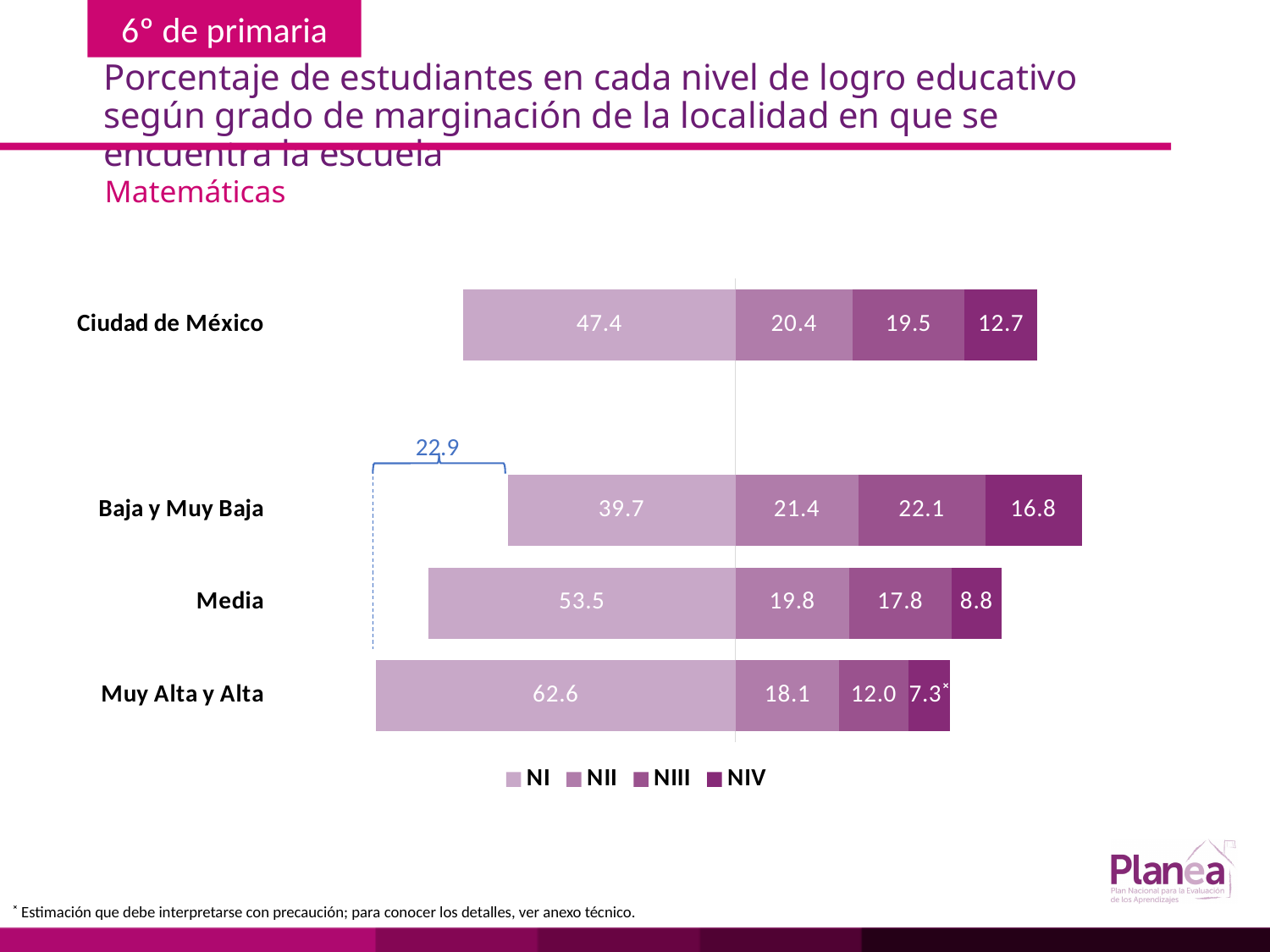
Which category has the lowest NIV value? Muy Alta y Alta What is the NII value for Media? 19.8 What is the NIII value for Muy Alta y Alta? 12.0 Which is larger: the NIII value for Baja y Muy Baja or the NIII value for Ciudad de México? Baja y Muy Baja What is the NIV value for Baja y Muy Baja? 16.8 What kind of chart is shown on the slide? Stacked bar chart What is the total of the stacked bar for Media? 99.9 What is the difference between the NI value for Muy Alta y Alta and the NI value for Baja y Muy Baja? 22.9 What is the NI value for Ciudad de México? 47.4 How many categories are shown on the chart? 4 How many series does the legend list? 4 Which category has the highest NI value? Muy Alta y Alta